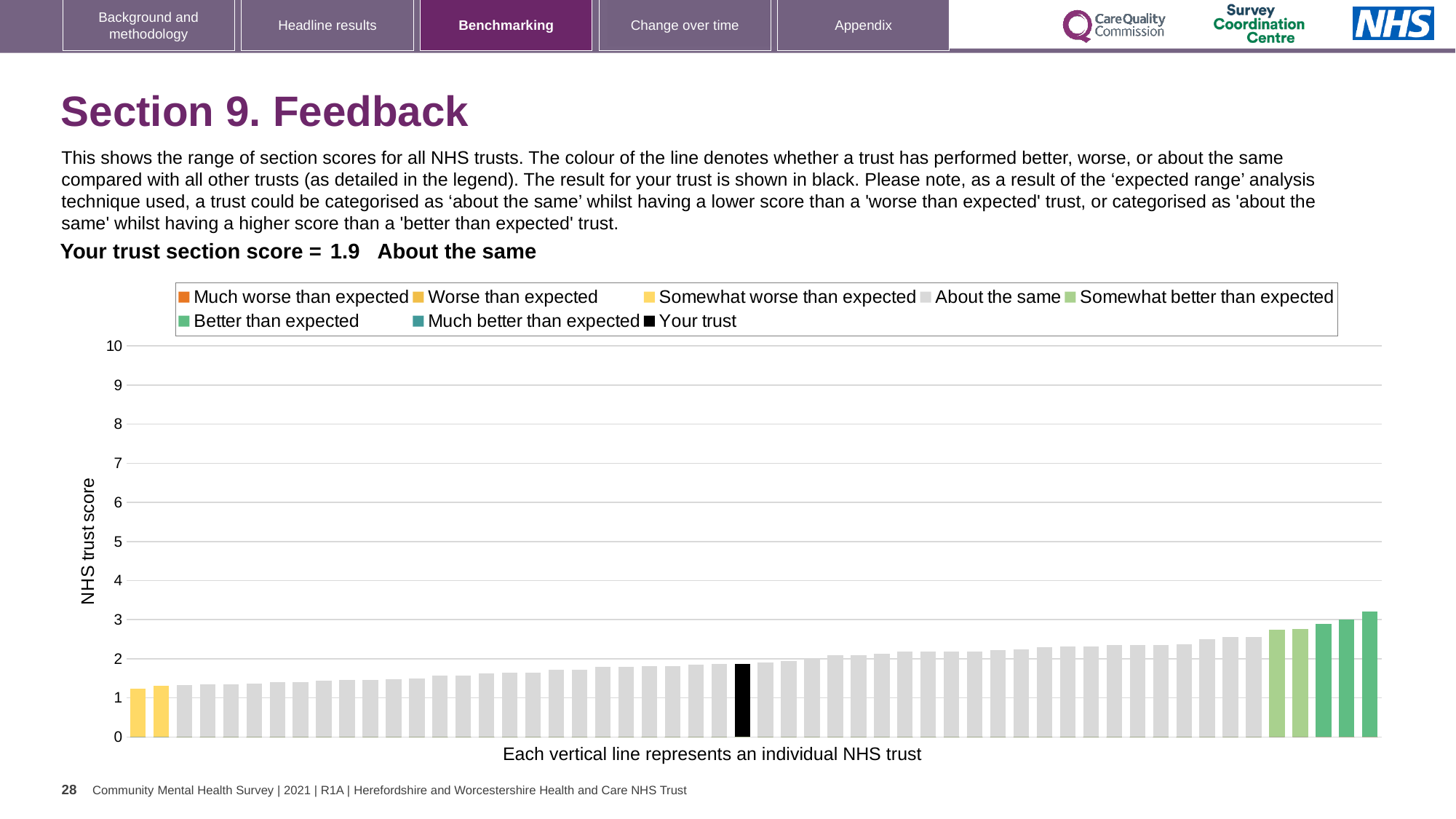
How is your trust's score categorised compared with other trusts? About the same Is the value of the lowest bar greater or less than 1? greater How many entries does the legend list? 8 Which legend category does the highest-scoring trust belong to? Better than expected Is the value for your trust greater or less than 2? less What kind of chart is shown on the slide? bar chart Is the value of the highest bar greater or less than 3? greater Do the bar values rise or fall from left to right along the x axis? rise What is the label on the vertical axis? NHS trust score What is the section score for your trust? 1.9 Which legend category does the lowest-scoring trust belong to? Somewhat worse than expected How many trusts are shown in the 'Somewhat worse than expected' colour? 2